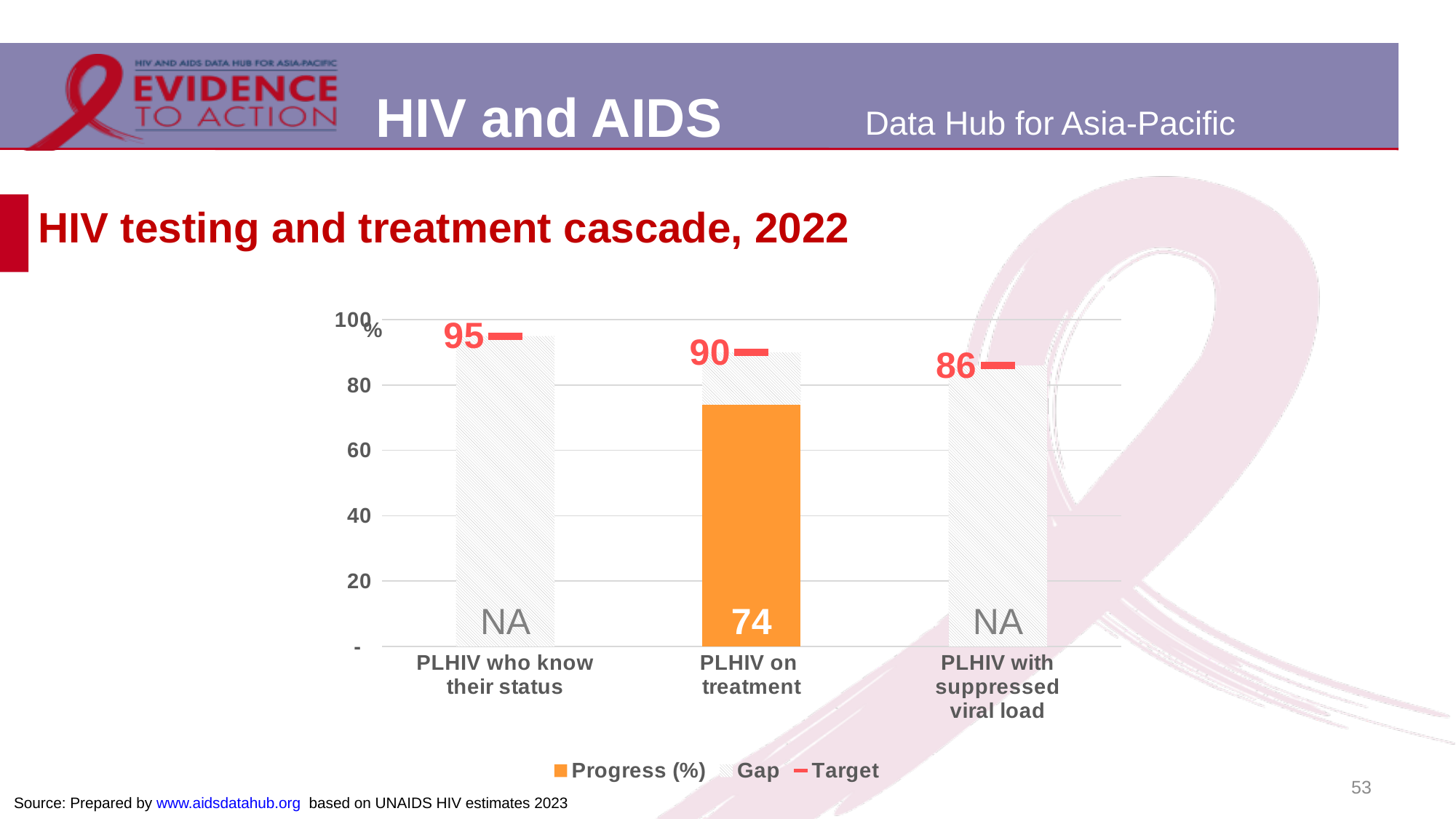
What is the Progress (%) value shown for PLHIV who know their status? NA Which category has the lowest Target value? PLHIV with suppressed viral load Is the Progress (%) value for PLHIV on treatment greater or less than 80? less What is the difference between the Target and the Progress (%) for PLHIV on treatment? 16 How many categories are shown on the x axis? 3 How many series does the legend list? 3 What is the Progress (%) value shown for PLHIV with suppressed viral load? NA What is the Progress (%) value for PLHIV on treatment? 74 Which category has the highest Target value? PLHIV who know their status What is the Target value for PLHIV on treatment? 90 What is the Target value for PLHIV who know their status? 95 What is the Target value for PLHIV with suppressed viral load? 86